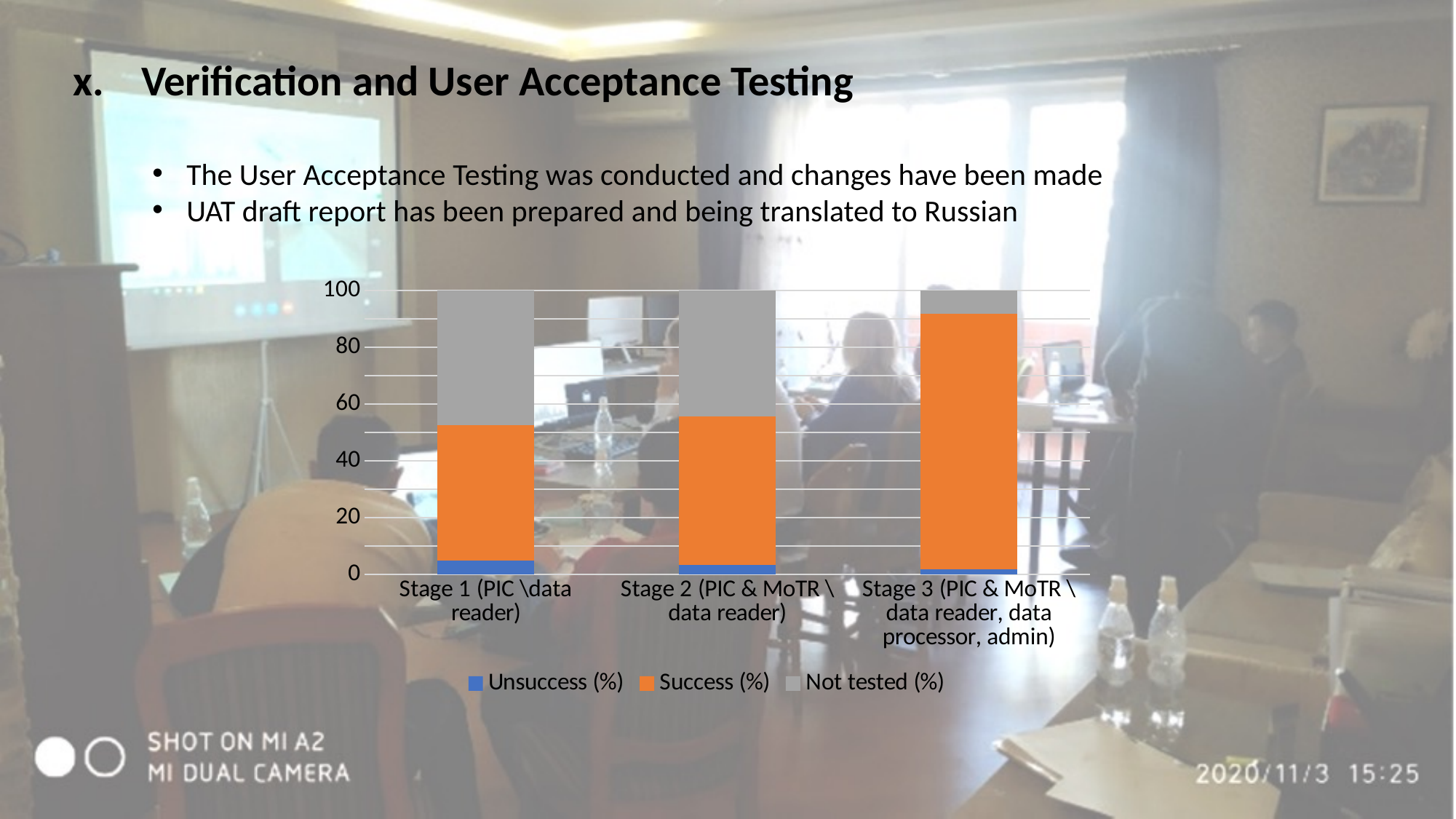
How many stages (categories) are shown on the x axis of the chart? 3 Which series is shown in blue in the chart? Unsuccess (%) Which series is shown in orange in the chart? Success (%) Is the Not tested (%) value for Stage 3 greater or less than 20? less Is the Success (%) value for Stage 1 greater or less than 60? less Which is larger, the Success (%) value for Stage 3 or for Stage 1? Stage 3 Which stage has the lowest Not tested (%) value? Stage 3 (PIC & MoTR \ data reader, data processor, admin) Is the Success (%) value for Stage 3 greater or less than 80? greater What kind of chart is shown on the slide? Stacked bar chart Which stage has the highest Success (%) value? Stage 3 (PIC & MoTR \ data reader, data processor, admin) How many series does the chart legend list? 3 Does the Success (%) value rise or fall from Stage 1 to Stage 3? rise